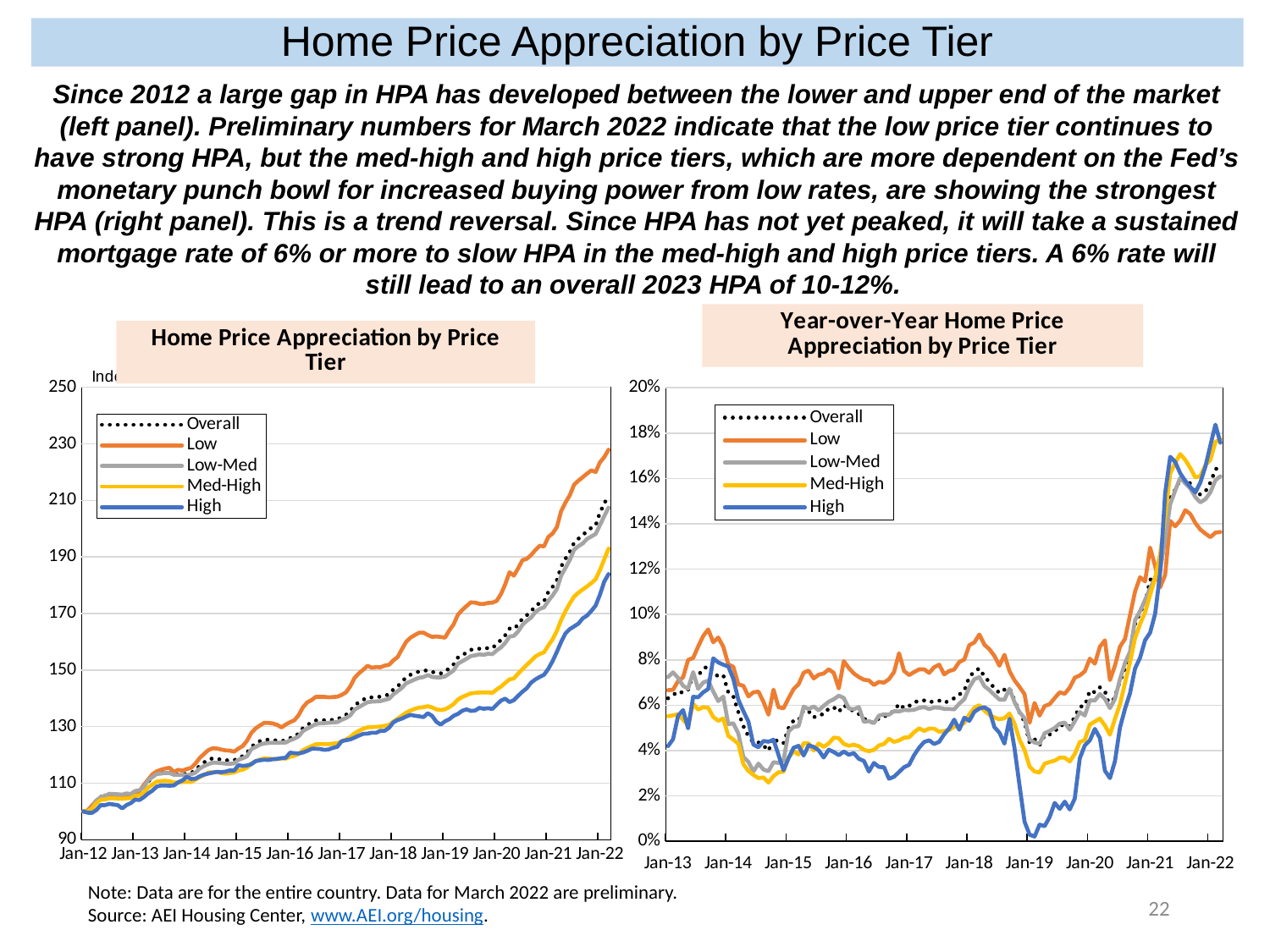
In the right chart, is the value of the High series around Jan-19 greater or less than 2%? less In the left chart, is the value of the Low series at Jan-22 greater or less than 210? greater What kind of chart is the left chart, 'Home Price Appreciation by Price Tier'? Line chart How many series does the legend of the left chart list? 5 In the left chart, which price tier series has the highest index value at Jan-22? Low How many series does the legend of the right chart list? 5 In the left chart, is the value of the High series at Jan-22 greater or less than 190? less In the right chart, which price tier series has the highest year-over-year value at Jan-22? High In the right chart, which series is drawn as a dotted black line? Overall What kind of chart is the right chart, 'Year-over-Year Home Price Appreciation by Price Tier'? Line chart In the left chart, do the index values generally rise or fall from Jan-12 to Jan-22? Rise In the left chart, which price tier series has the lowest index value at Jan-22? High